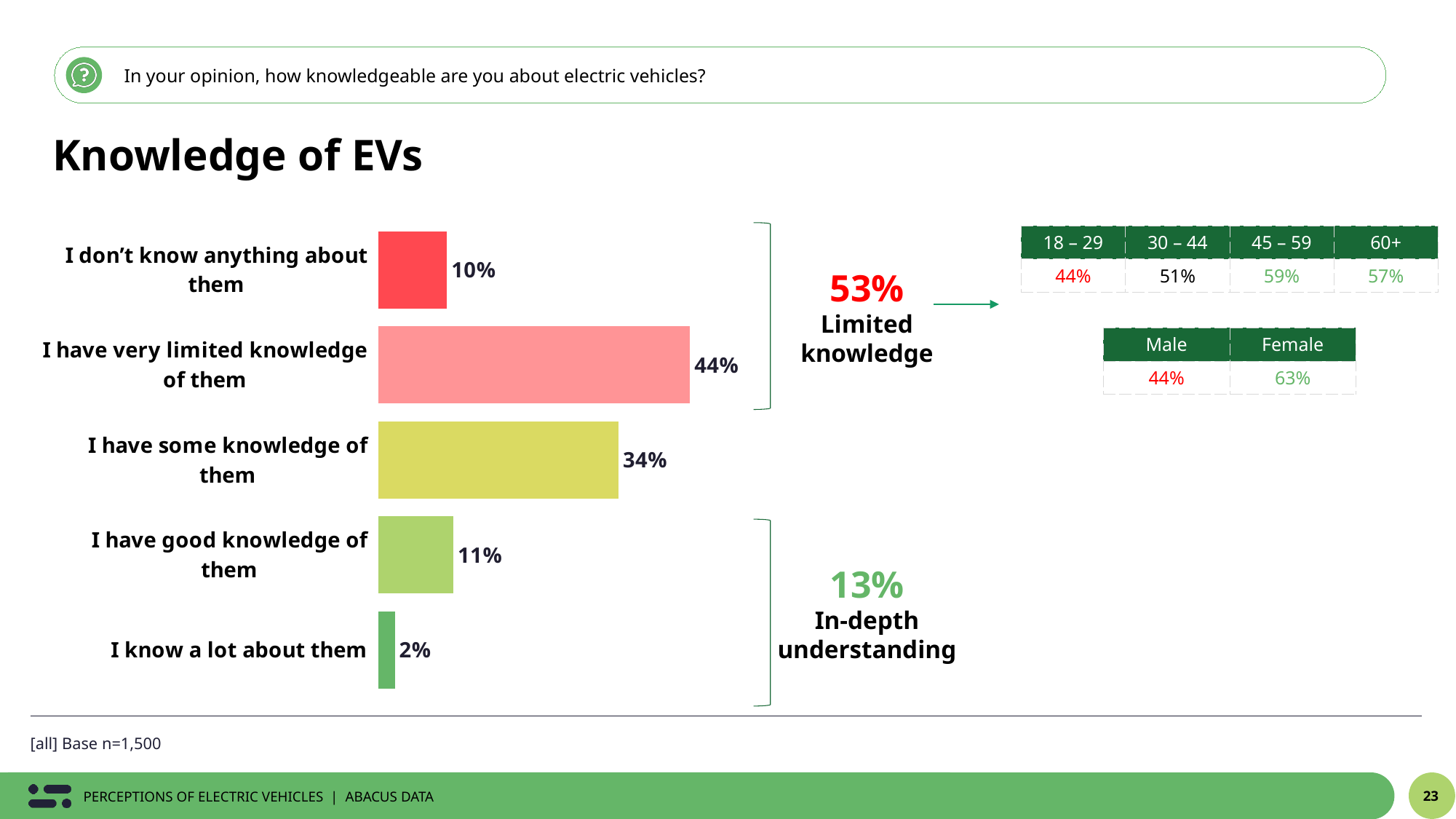
What combined percentage is labelled as 'Limited knowledge'? 53% What combined percentage is labelled as 'In-depth understanding'? 13% What percentage of respondents said they know a lot about electric vehicles? 2% Which response category has the highest percentage? I have very limited knowledge of them What is the total of the percentages for 'I have good knowledge of them' and 'I know a lot about them'? 13% Which is larger: the percentage for 'I don't know anything about them' or 'I have good knowledge of them'? I have good knowledge of them Which response category has the lowest percentage? I know a lot about them What kind of chart is used to show knowledge of EVs? Bar chart What percentage of respondents said they have very limited knowledge of electric vehicles? 44% What percentage of respondents said they have some knowledge of electric vehicles? 34% How many response categories are shown in the chart? 5 What is the difference between the percentage for 'I have some knowledge of them' and 'I have good knowledge of them'? 23%